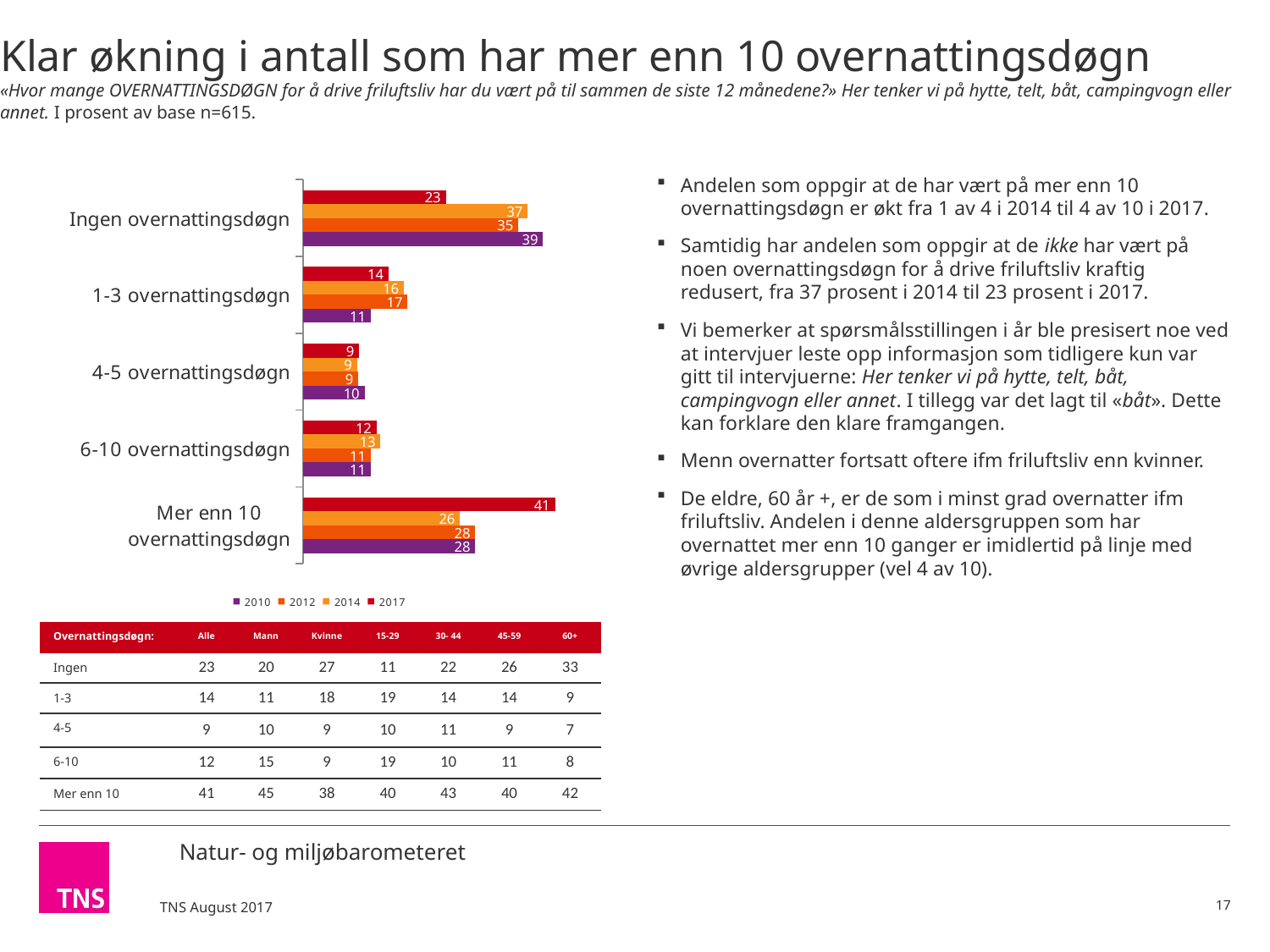
What is the 2012 value for '1-3 overnattingsdøgn'? 17 Which is larger for 'Ingen overnattingsdøgn': the 2010 value or the 2017 value? 2010 Which category has the highest 2017 value? Mer enn 10 overnattingsdøgn Which category has the lowest 2010 value? 4-5 overnattingsdøgn What kind of chart is shown on the slide? bar chart Which series is shown in purple in the legend? 2010 What is the 2017 value for 'Mer enn 10 overnattingsdøgn'? 41 What is the difference between the 2017 and 2014 values for 'Mer enn 10 overnattingsdøgn'? 15 How many series does the chart legend list? 4 What is the 2014 value for 'Ingen overnattingsdøgn'? 37 What is the 2010 value for 'Ingen overnattingsdøgn'? 39 How many categories are shown on the chart? 5